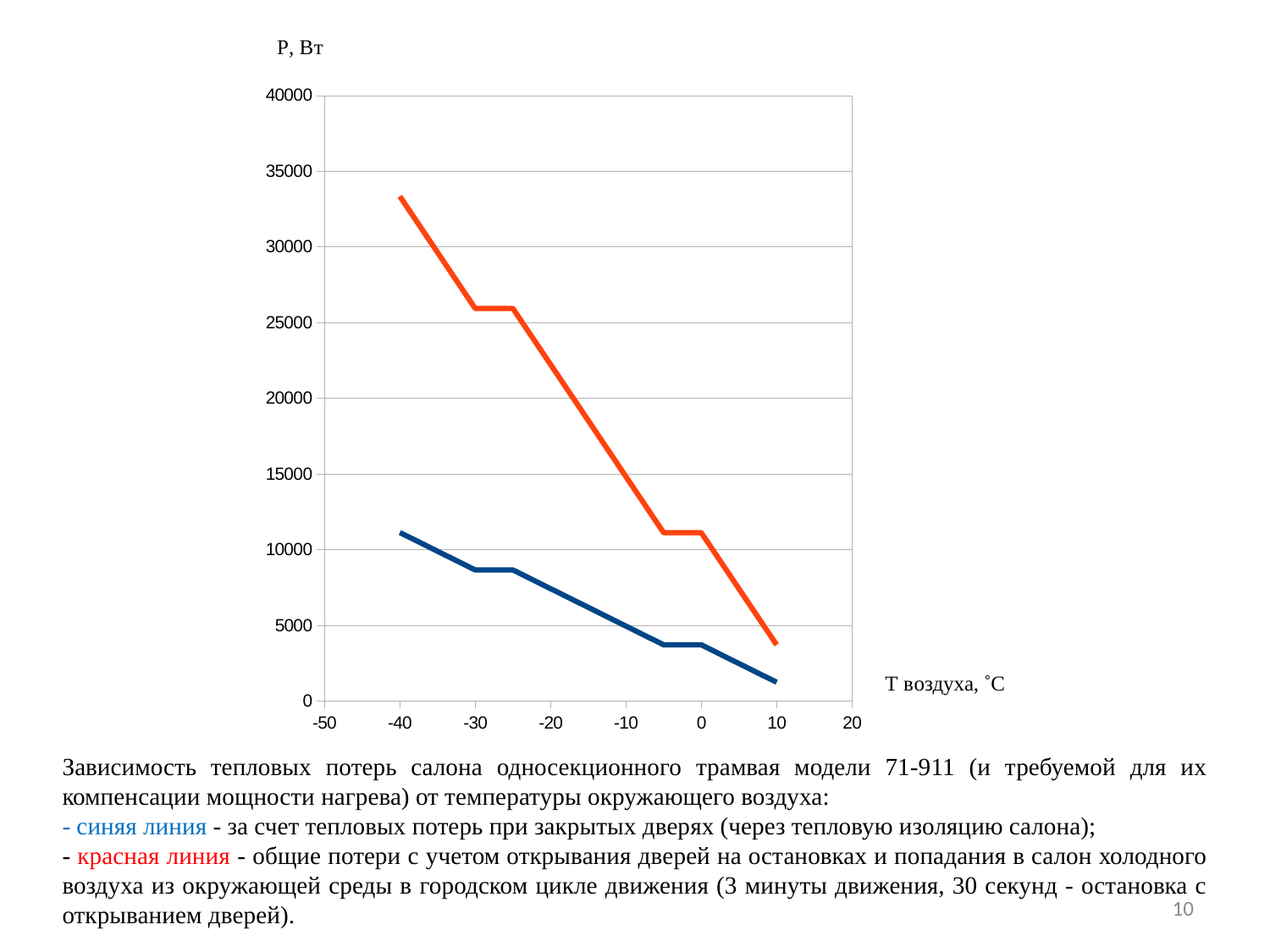
Is the value of the blue line at -30 °C greater or less than 10000? less Do the values of the blue line rise or fall as the air temperature increases along the x axis? fall At -40 °C, which line has the larger value, the red line or the blue line? red line Is the value of the red line at -40 °C greater or less than 30000? greater What kind of chart is shown on the slide? line chart How many lines are plotted on the chart? 2 Do the values of the red line rise or fall as the air temperature increases along the x axis? fall Is the value of the red line at 10 °C greater or less than 5000? less What is the label of the horizontal axis? T воздуха, °C What is the label of the vertical axis? P, Вт